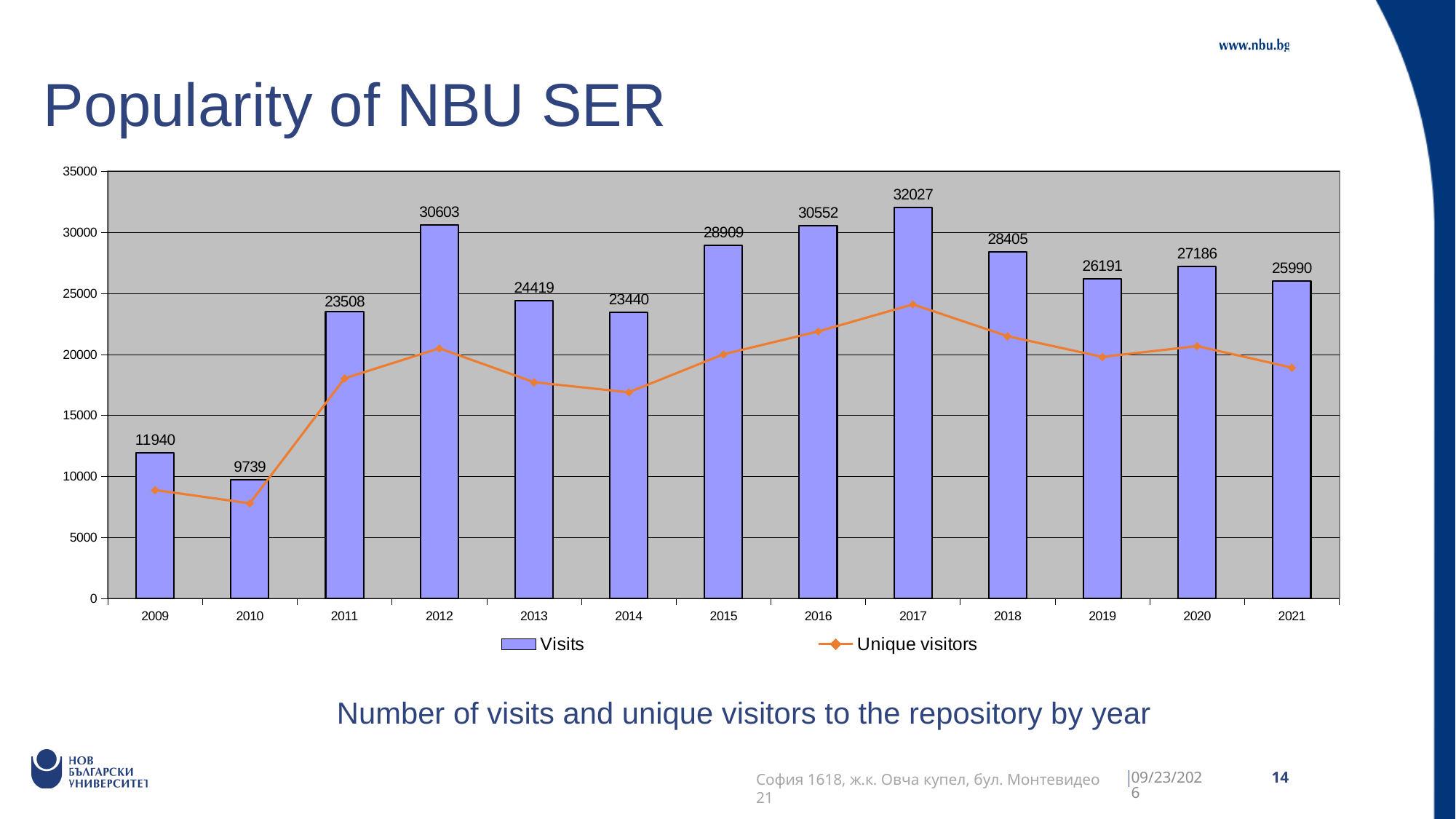
What is the number of Visits in 2012? 30603 Is the value for Unique visitors in 2010 greater or less than 10000? less Which year has the lowest number of Visits? 2010 What is the difference in Visits between 2017 and 2016? 1475 Which year had more Visits, 2013 or 2014? 2013 Do the Visits values rise or fall from 2017 to 2019? fall How many years are shown on the x axis? 13 What is the number of Visits in 2010? 9739 Which year has the highest number of Visits? 2017 How many series does the legend list? 2 What is the difference in Visits between 2012 and 2011? 7095 Is the value for Unique visitors in 2017 greater or less than 20000? greater